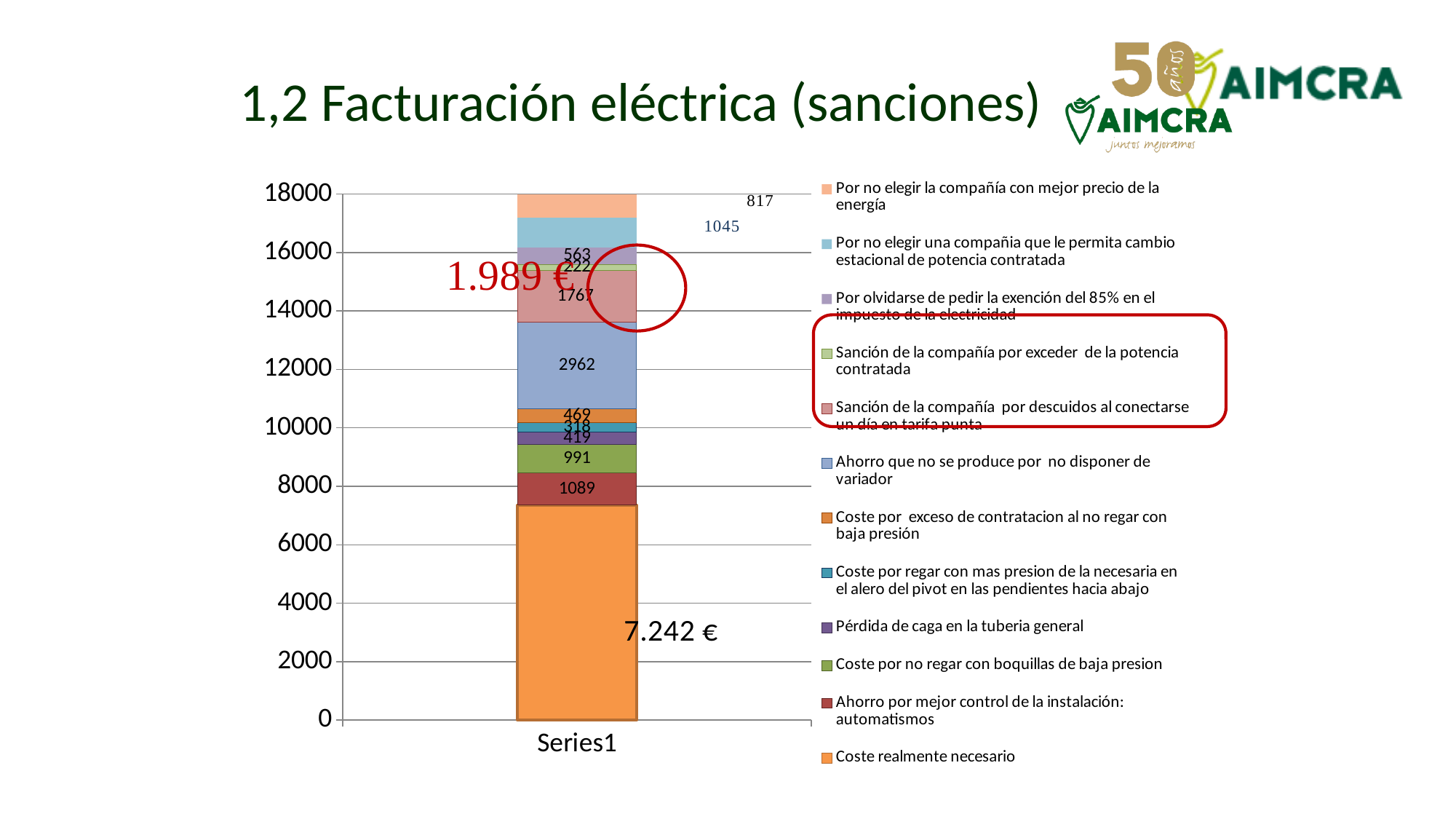
What is the difference between the 'Ahorro que no se produce por no disponer de variador' segment (2962) and the 'Sanción de la compañía por descuidos al conectarse un día en tarifa punta' segment (1767)? 1195 What is the value of the segment 'Ahorro que no se produce por no disponer de variador'? 2962 Which segment is larger: 'Ahorro por mejor control de la instalación: automatismos' or 'Coste por no regar con boquillas de baja presion'? Ahorro por mejor control de la instalación: automatismos Which legend entry corresponds to the smallest segment of the stacked bar? Sanción de la compañía por exceder de la potencia contratada What kind of chart is shown on the slide? stacked bar chart What is the value of the segment 'Pérdida de caga en la tuberia general'? 419 What is the value of the segment 'Sanción de la compañía por descuidos al conectarse un día en tarifa punta'? 1767 Which legend entry corresponds to the largest segment of the stacked bar? Coste realmente necesario How many series does the legend list? 12 What is the value of the segment 'Coste por no regar con boquillas de baja presion'? 991 Is the total height of the stacked bar greater or less than 16000? greater What is the value of the segment 'Por no elegir la compañía con mejor precio de la energía'? 817